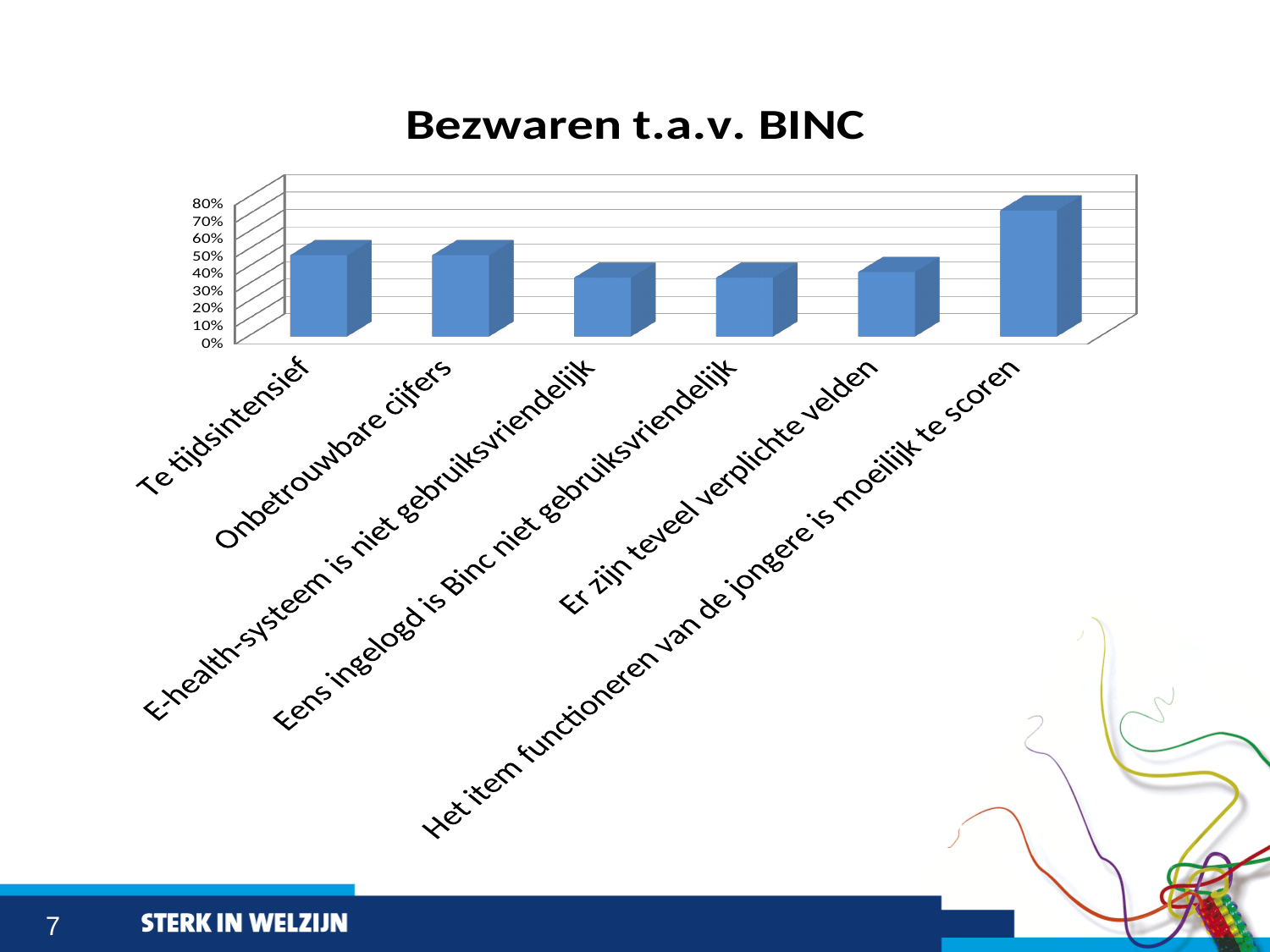
Is the value for 'E-health-systeem is niet gebruiksvriendelijk' greater or less than 60%? less Is the value for 'Er zijn teveel verplichte velden' greater or less than 70%? less What is the highest value shown on the vertical axis? 80% Which category has the highest value? Het item functioneren van de jongere is moeilijk te scoren Which is larger: the value for 'Onbetrouwbare cijfers' or the value for 'Eens ingelogd is Binc niet gebruiksvriendelijk'? Onbetrouwbare cijfers What is the title of the chart? Bezwaren t.a.v. BINC How many categories are shown in the chart? 6 Is the value for 'Te tijdsintensief' greater or less than 30%? greater Which is larger: the value for 'Het item functioneren van de jongere is moeilijk te scoren' or the value for 'Te tijdsintensief'? Het item functioneren van de jongere is moeilijk te scoren What kind of chart is shown on the slide? bar chart